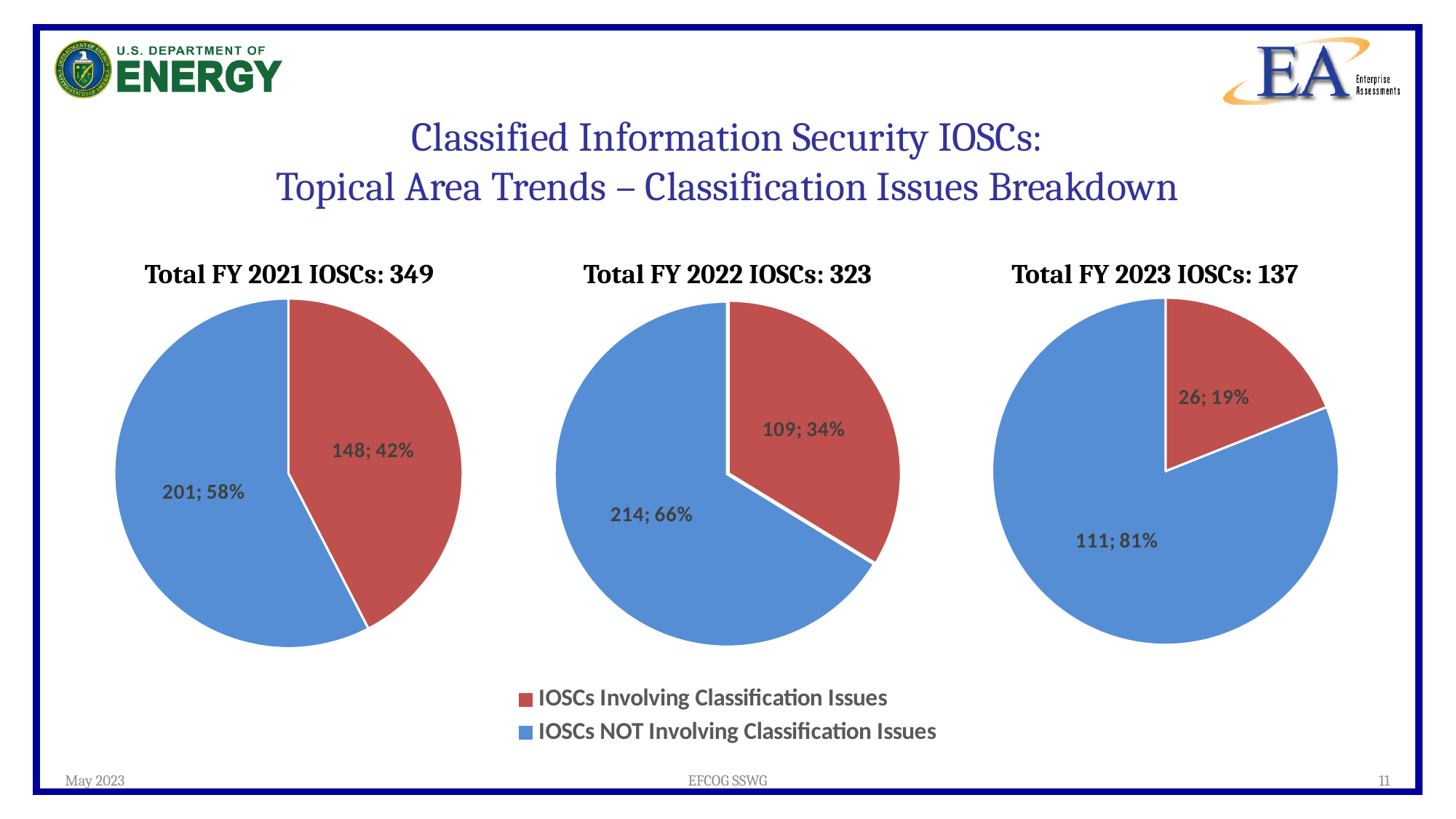
What type of chart is used on this slide? Pie chart In the 'Total FY 2023 IOSCs: 137' pie chart, how many IOSCs involved classification issues? 26 In the 'Total FY 2023 IOSCs: 137' pie chart, what share of the pie is taken by IOSCs involving classification issues? 19% In the 'Total FY 2021 IOSCs: 349' pie chart, which category has the smallest slice? IOSCs Involving Classification Issues In the 'Total FY 2021 IOSCs: 349' pie chart, how many IOSCs involved classification issues? 148 How many entries does the shared legend list? 2 In the 'Total FY 2022 IOSCs: 323' pie chart, what is the difference between the number of IOSCs NOT involving classification issues and those involving classification issues? 105 What colour represents IOSCs NOT involving classification issues in the pie charts? Blue How many slices does the 'Total FY 2022 IOSCs: 323' pie chart have? 2 In the 'Total FY 2021 IOSCs: 349' pie chart, what share of the pie is taken by IOSCs NOT involving classification issues? 58% In the 'Total FY 2023 IOSCs: 137' pie chart, which slice is larger: IOSCs involving classification issues or IOSCs NOT involving classification issues? IOSCs NOT Involving Classification Issues In the 'Total FY 2022 IOSCs: 323' pie chart, what percentage of IOSCs did NOT involve classification issues? 66%